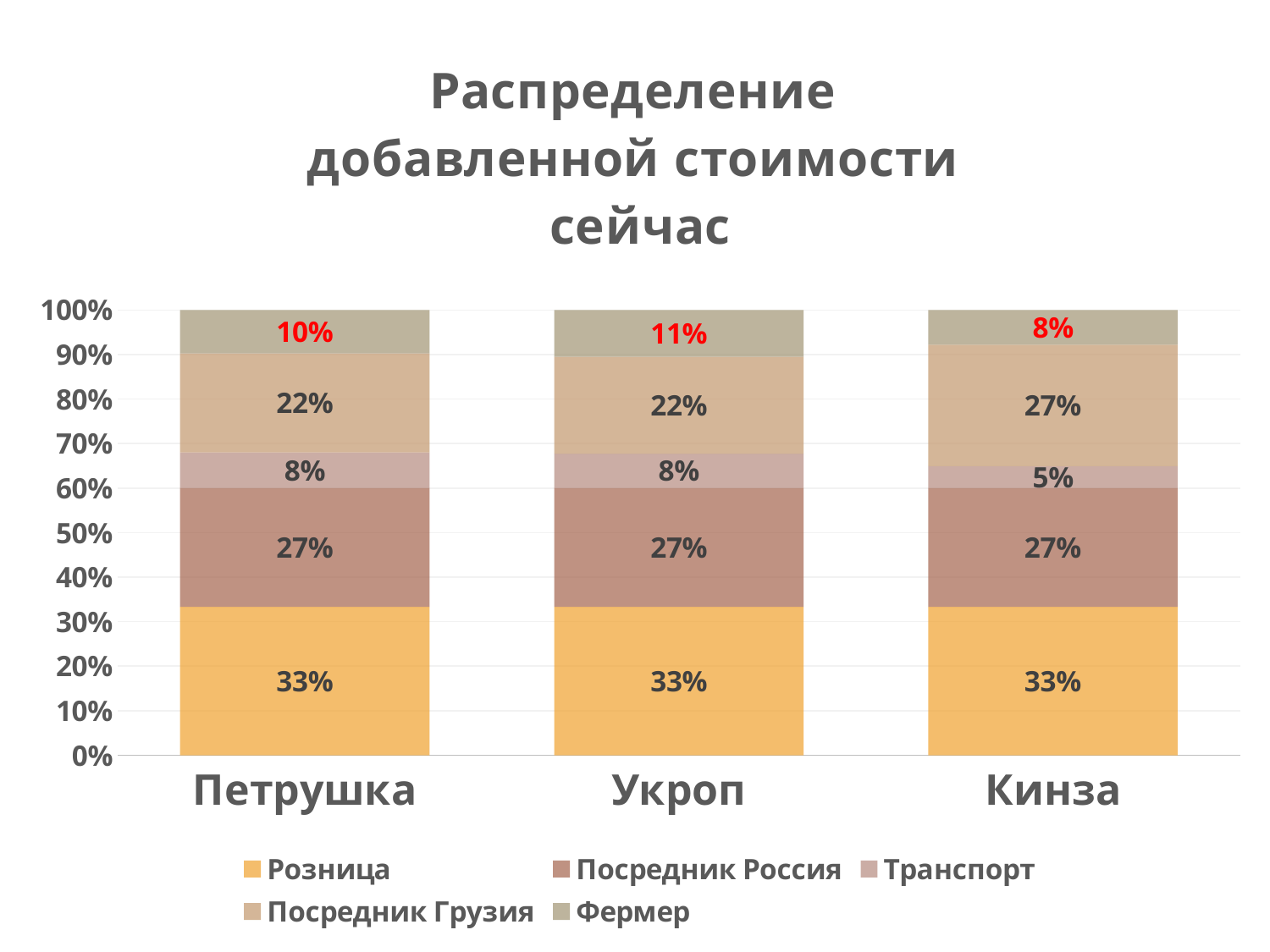
How many categories are shown on the x axis? 3 What is the title of the chart? Распределение добавленной стоимости сейчас What is the value for Транспорт in the Кинза bar? 5% Which is larger: the Фермер share for Петрушка or for Кинза? Петрушка What share of added value goes to Фермер for Кинза? 8% Which category has the lowest Транспорт share? Кинза What is the difference between the Посредник Грузия share for Кинза and for Петрушка? 5% What kind of chart is shown on the slide? Stacked bar chart What is the value for Розница in the Петрушка bar? 33% What is the value for Посредник Грузия in the Укроп bar? 22% Which category has the highest Фермер share? Укроп How many series does the legend list? 5